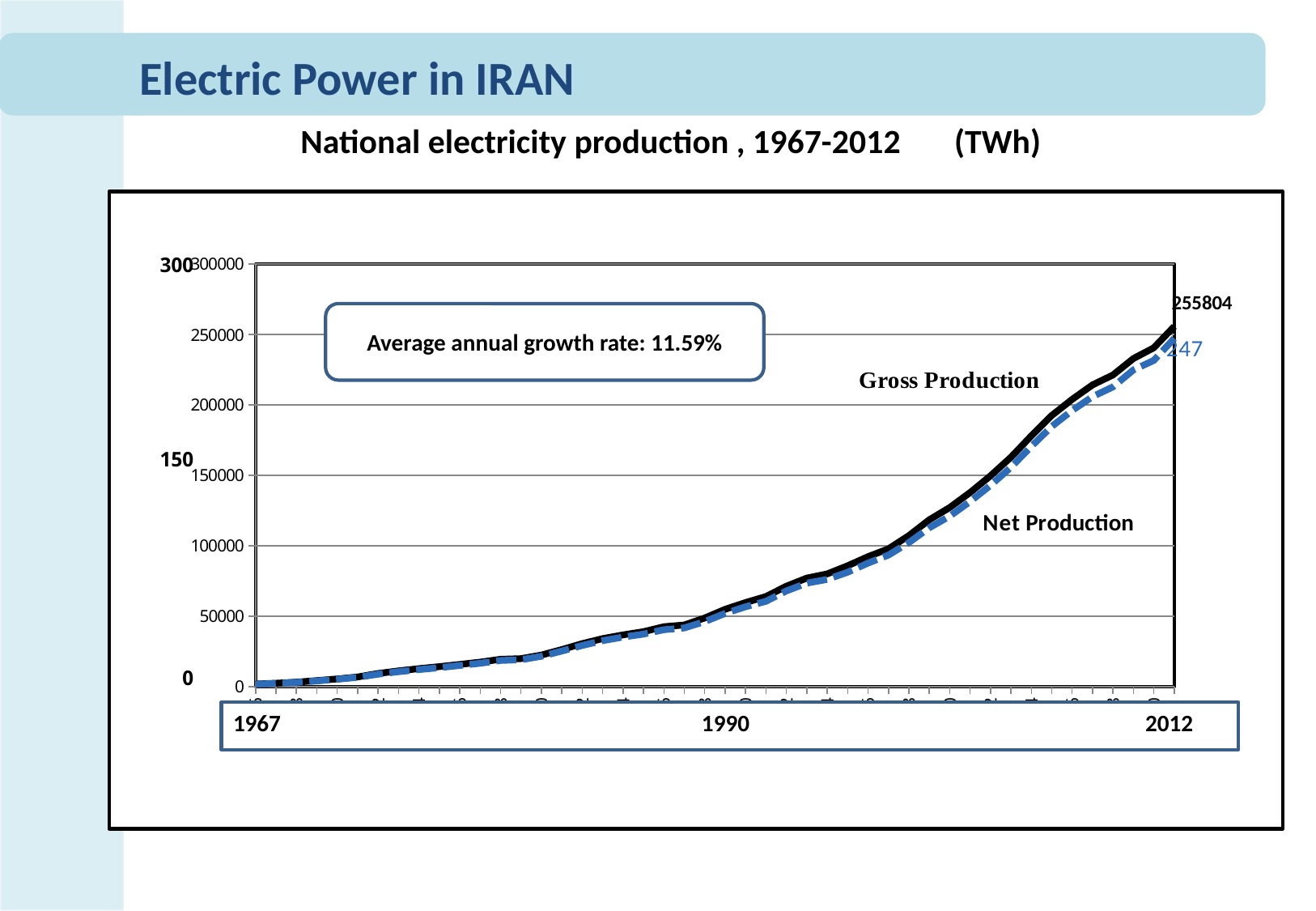
What is the title of the chart? National electricity production , 1967-2012 (TWh) What average annual growth rate is stated in the box on the chart? 11.59% What is the Gross Production value labelled at the end of the series in 2012? 255804 Is the Gross Production value in 1990 greater or less than 100000? less In which year shown on the x axis is Gross Production lowest? 1967 Is the Gross Production value in 1967 greater or less than 50000? less Is the Net Production value in 2012 greater or less than 200000? greater How many data series are plotted on the chart? 2 In 2012, which series is higher, Gross Production or Net Production? Gross Production What kind of chart is shown on the slide? line chart In which year shown on the x axis is Gross Production highest? 2012 Do the production values rise or fall from 1967 to 2012? rise